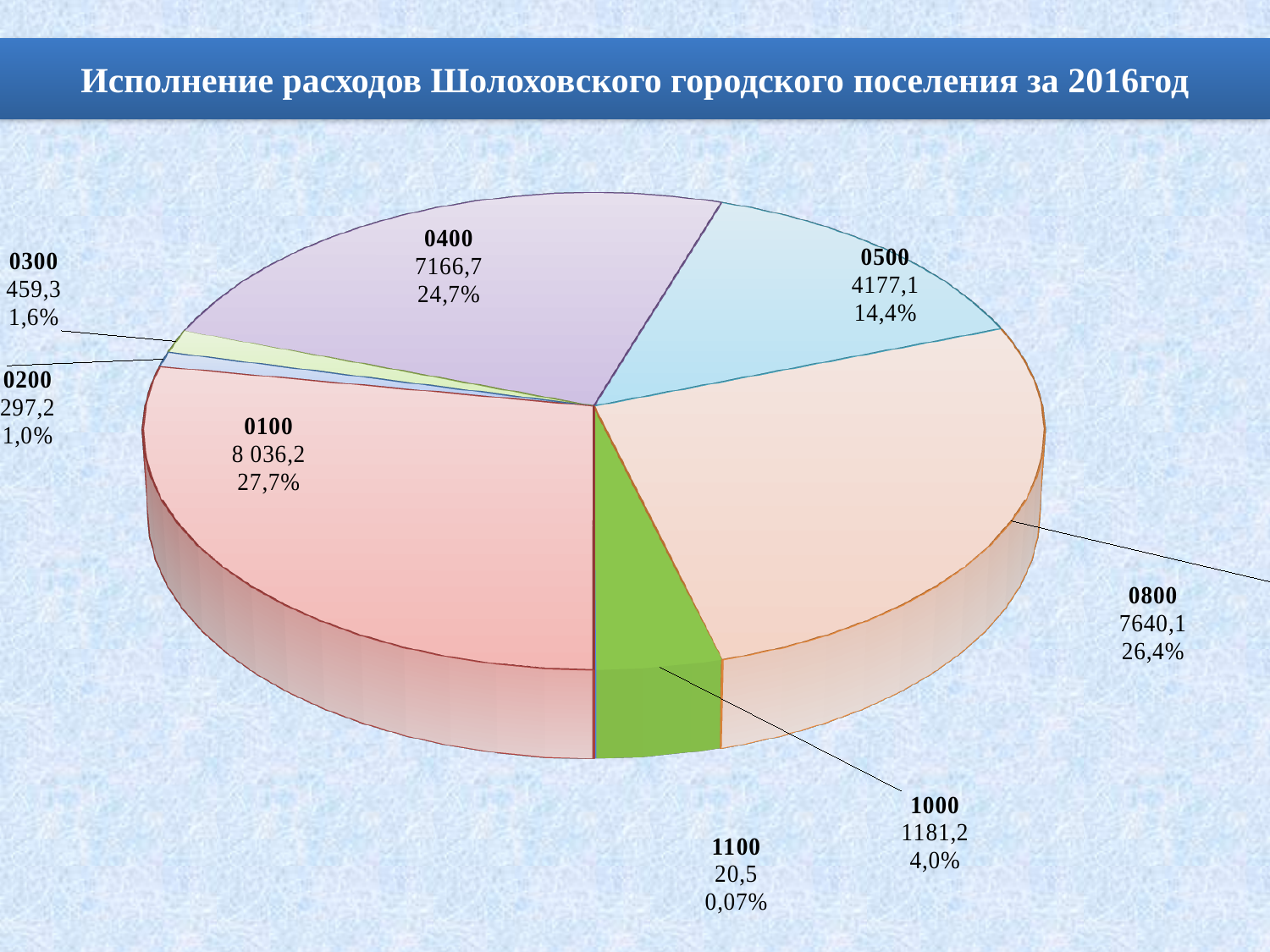
Which is larger, the value for 0400 or the value for 0800? 0800 What kind of chart is shown on the slide? pie chart Which category has the smallest share of the pie? 1100 Which category has the largest share of the pie? 0100 What is the value shown for category 1100? 20,5 What is the difference between the values for 0300 and 0200? 162,1 What is the title of the slide containing the chart? Исполнение расходов Шолоховского городского поселения за 2016год What share of the pie does category 0800 represent? 26,4% What is the value shown for category 0500? 4177,1 What is the value shown for category 0100? 8 036,2 How many categories (slices) does the pie chart have? 8 What share of the pie does category 0400 represent? 24,7%